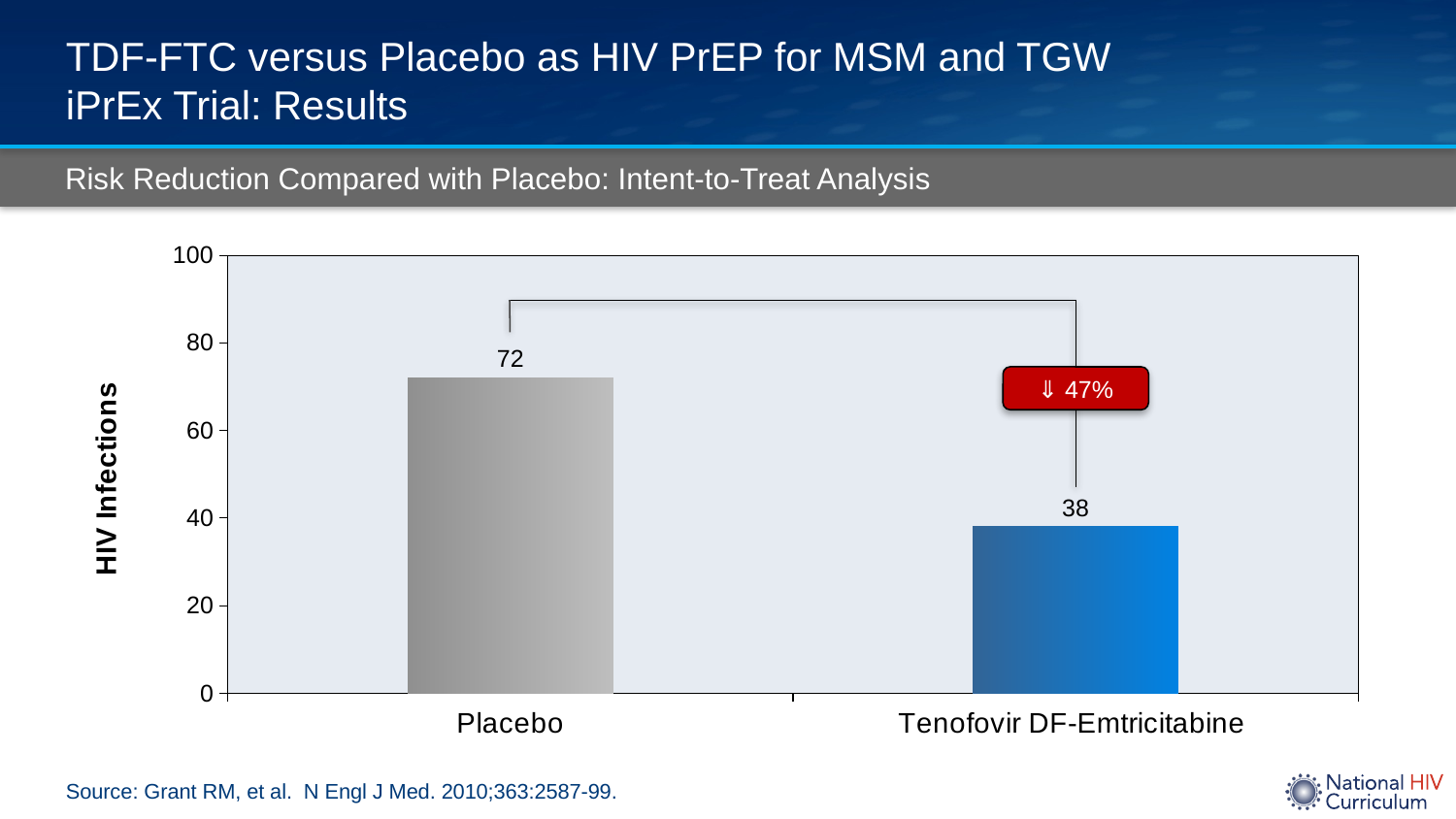
How many categories are plotted on the chart? 2 What is the label of the y-axis? HIV Infections How many HIV infections are shown for the Tenofovir DF-Emtricitabine group? 38 Which group has the higher number of HIV infections? Placebo How many HIV infections are shown for the Placebo group? 72 Is the value for Tenofovir DF-Emtricitabine greater or less than 40? less What is the difference in HIV infections between the Placebo and Tenofovir DF-Emtricitabine groups? 34 Is the number of HIV infections larger for Placebo or for Tenofovir DF-Emtricitabine? Placebo Which group has the lower number of HIV infections? Tenofovir DF-Emtricitabine Is the value for Placebo greater or less than 60? greater What percentage risk reduction is shown in the red callout on the chart? 47% What kind of chart is shown on the slide? Bar chart